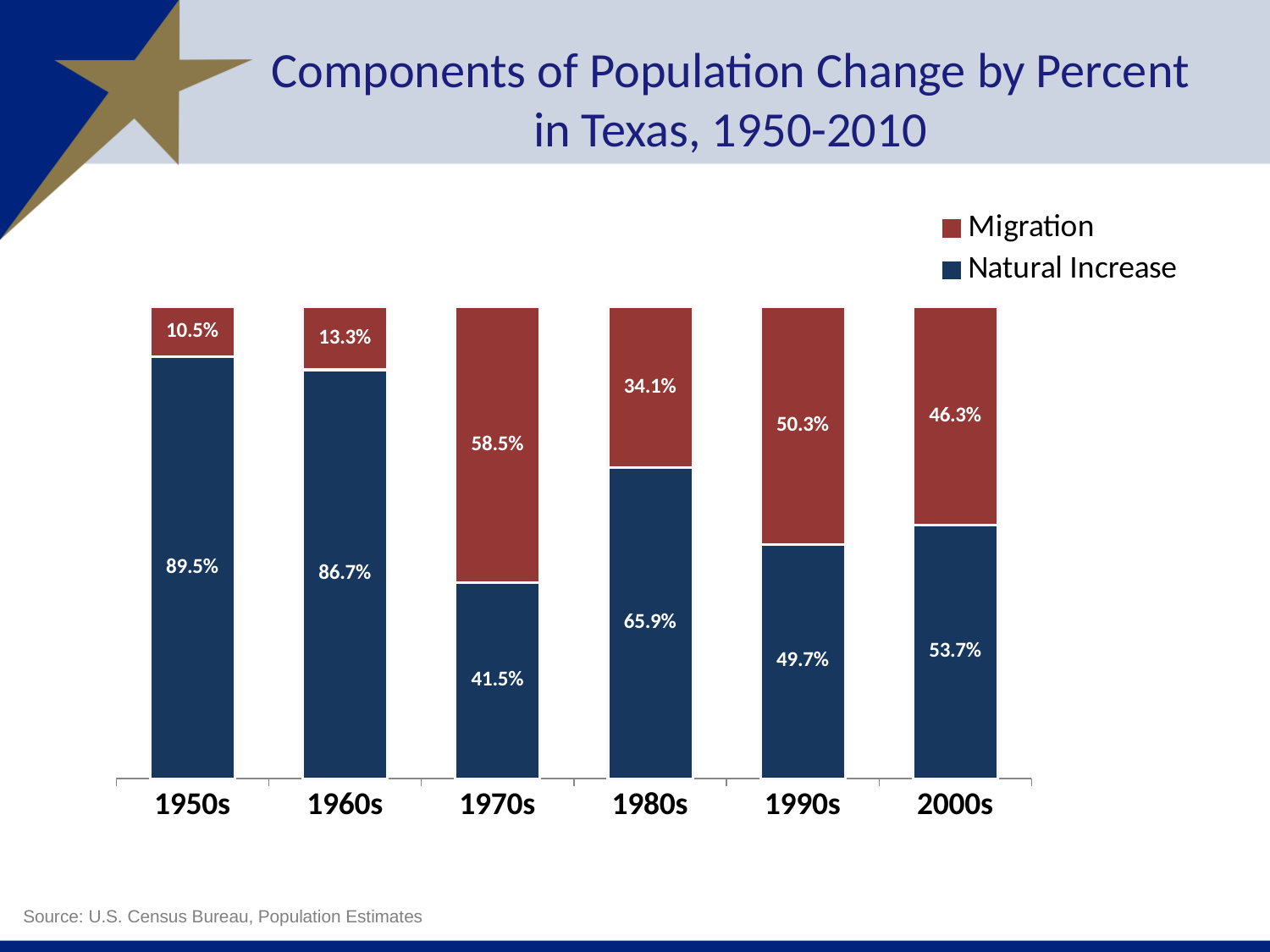
What is the Natural Increase value for the 2000s? 53.7% Which is larger in the 1990s, Migration or Natural Increase? Migration How many series does the legend list? 2 How many decades are shown on the x axis? 6 What is the total of the stacked bar for the 1980s? 100% What is the Migration value for the 1970s? 58.5% What is the Migration value for the 1980s? 34.1% Which decade has the highest Migration share? 1970s What is the Natural Increase value for the 1950s? 89.5% What is the difference between the Natural Increase values for the 1950s and the 1960s? 2.8% Which decade has the lowest Natural Increase share? 1970s What kind of chart is shown on the slide? Stacked bar chart